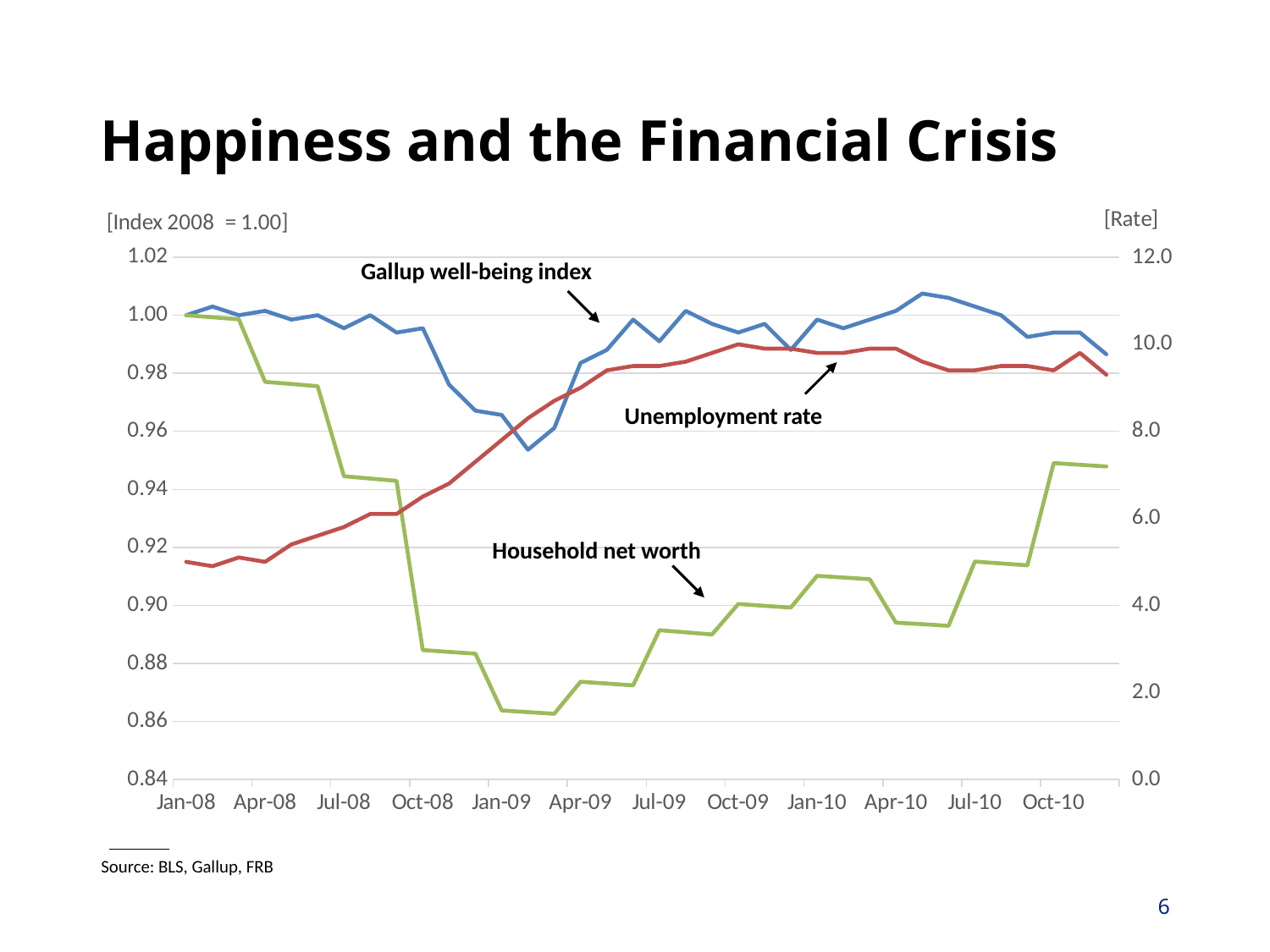
At Jan-09, which is higher: the Gallup well-being index or household net worth? Gallup well-being index Which series is plotted against the right-hand [Rate] axis? Unemployment rate Is the unemployment rate at Oct-09 greater or less than 8.0? greater Is the household net worth value at Jan-09 greater or less than 0.88? less Does household net worth rise or fall between Jan-08 and Jan-09? fall Does the unemployment rate rise or fall between Jan-08 and Oct-09? rise How many data series are plotted on the chart? 3 Is the unemployment rate at Jan-08 greater or less than 6.0? less What is the title of the slide's chart? Happiness and the Financial Crisis What kind of chart is shown on the slide? line chart How many date labels are shown on the x axis? 12